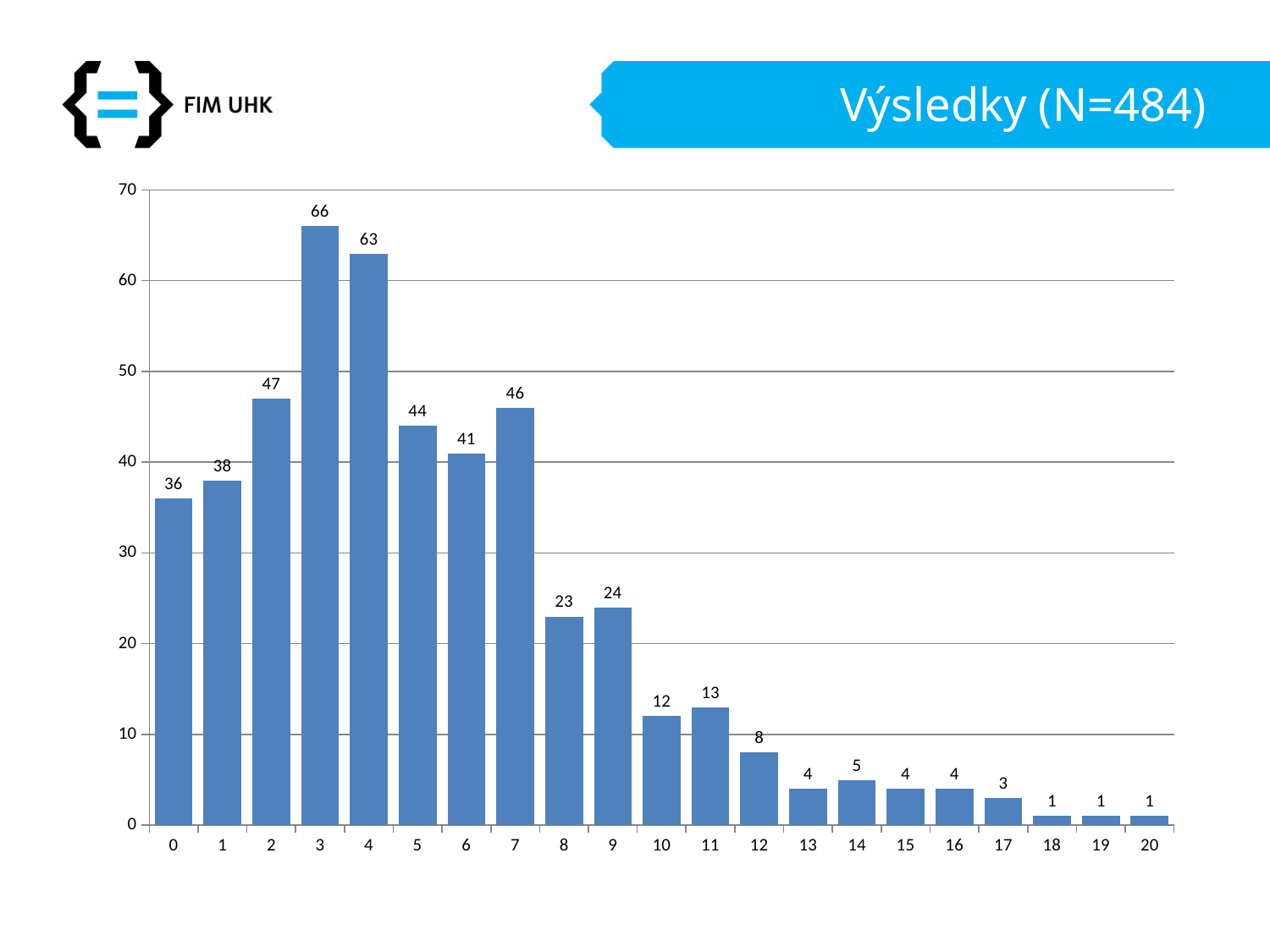
Which category has the highest value? 3 What is the difference between the values for categories 3 and 4? 3 What is the value for category 12? 8 What is the title of the slide containing the chart? Výsledky (N=484) How many categories are shown on the x axis? 21 What is the value for category 9? 24 What kind of chart is shown on the slide? bar chart Do the values rise or fall along the x axis from category 9 to category 20? fall Which is larger, the value for category 5 or the value for category 7? 7 Is the value for category 10 greater or less than 20? less What is the difference between the values for categories 2 and 8? 24 What is the value for category 3? 66